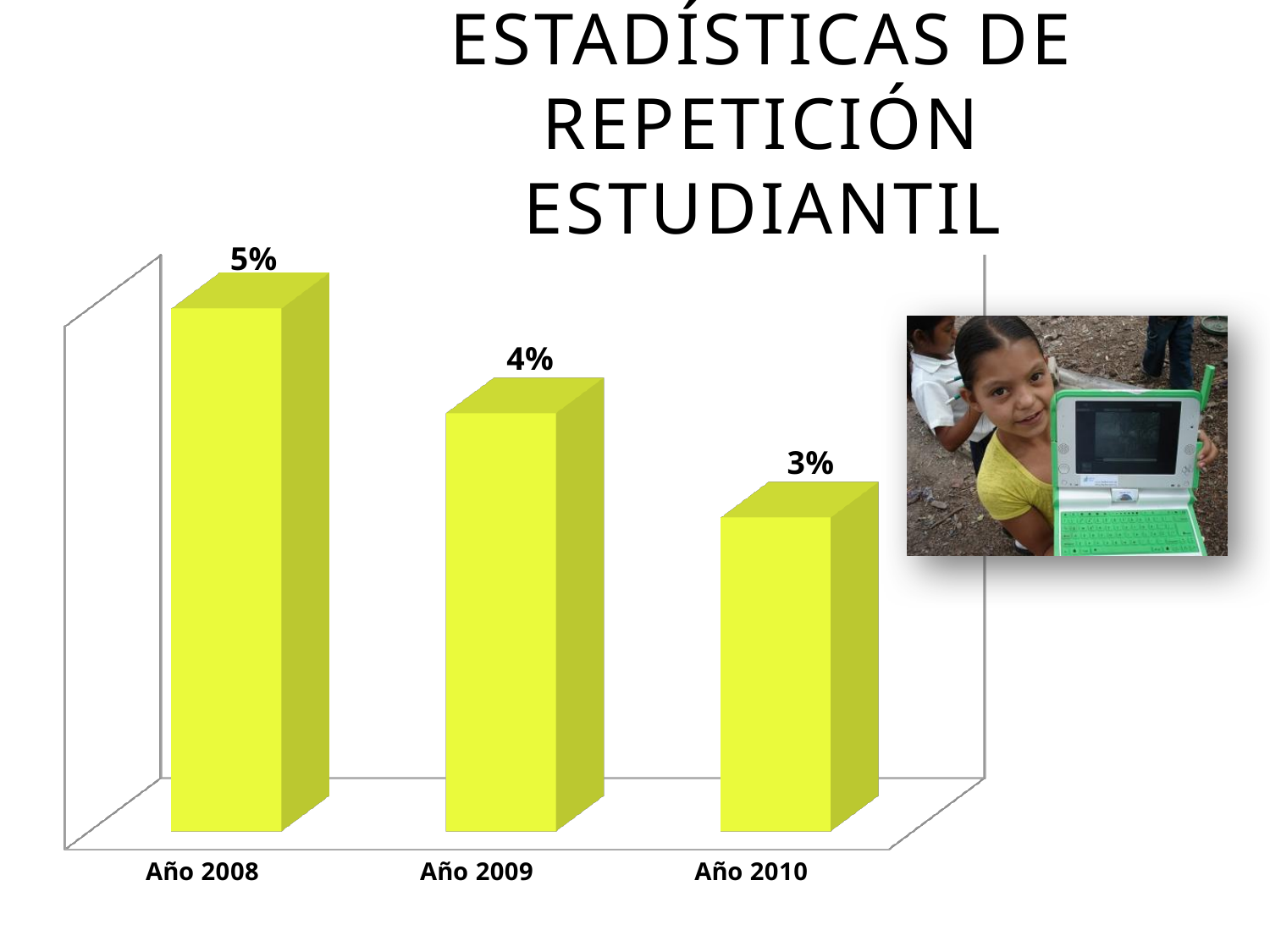
What is the difference between the values for Año 2009 and Año 2010? 1% What is the value for Año 2009? 4% What is the value for Año 2008? 5% Which year has the highest value? Año 2008 How many categories are shown on the chart? 3 Which year has the lowest value? Año 2010 Which is larger, the value for Año 2008 or Año 2009? Año 2008 What is the difference between the values for Año 2008 and Año 2010? 2% What kind of chart is shown on the slide? bar chart Do the values rise or fall from Año 2008 to Año 2010? fall What is the title of the chart? ESTADÍSTICAS DE REPETICIÓN ESTUDIANTIL What is the value for Año 2010? 3%